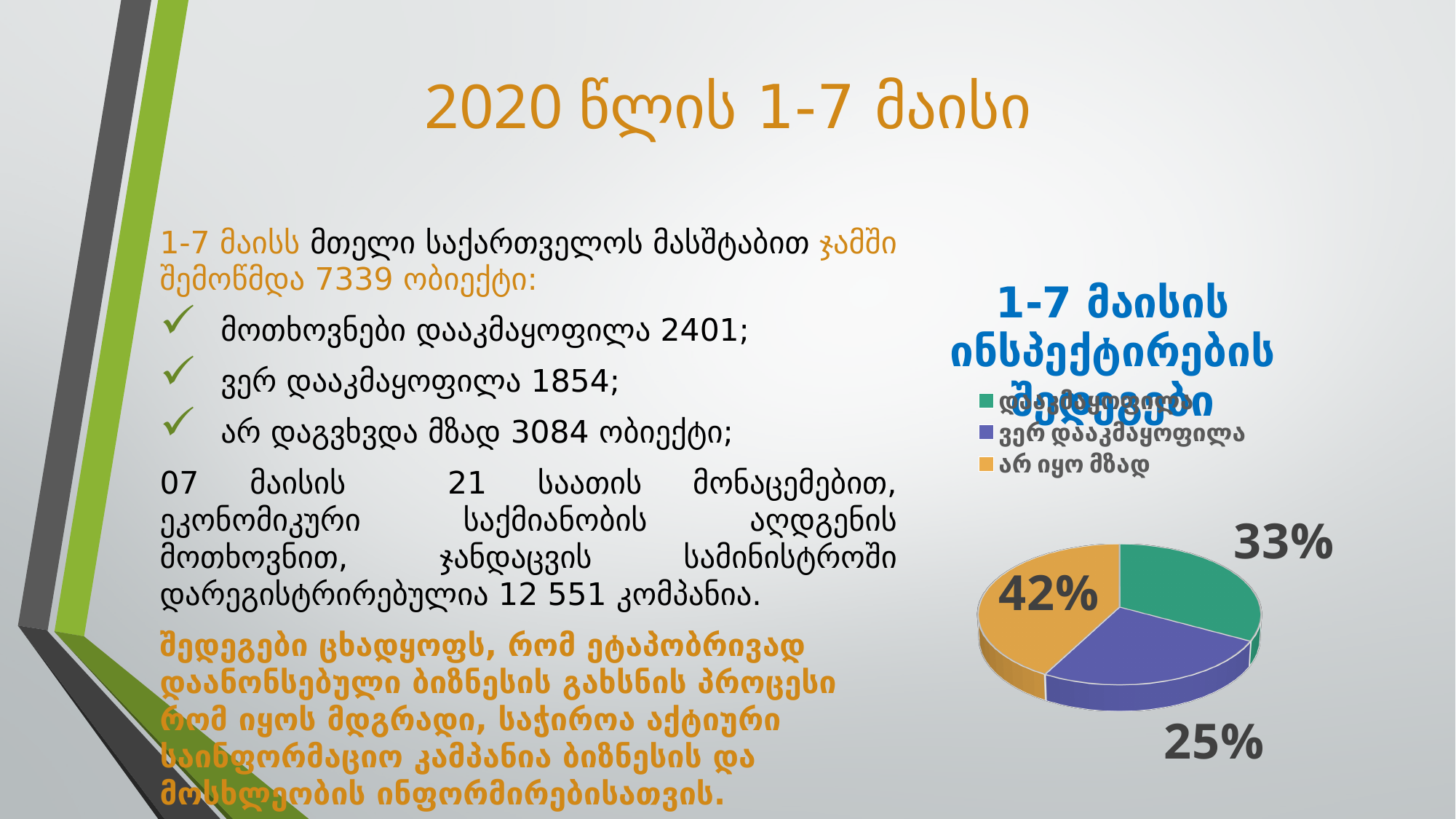
What share of the pie does the slice labelled "არ იყო მზად" represent? 42% Which slice of the pie chart is the smallest? ვერ დააკმაყოფილა How many entries does the legend of the pie chart list? 3 What share of the pie does the slice labelled "ვერ დააკმაყოფილა" represent? 25% What kind of chart is shown on the slide? pie chart What is the title of the pie chart? 1-7 მაისის ინსპექტირების შედეგები Which is larger: the green slice or the "ვერ დააკმაყოფილა" slice? the green slice How many slices does the pie chart have? 3 What is the difference in percentage points between the "არ იყო მზად" slice and the "ვერ დააკმაყოფილა" slice? 17 What percentage is shown for the green slice of the pie chart? 33% Which slice of the pie chart is the largest? არ იყო მზად What colour is the slice labelled "არ იყო მზად" in the pie chart? orange